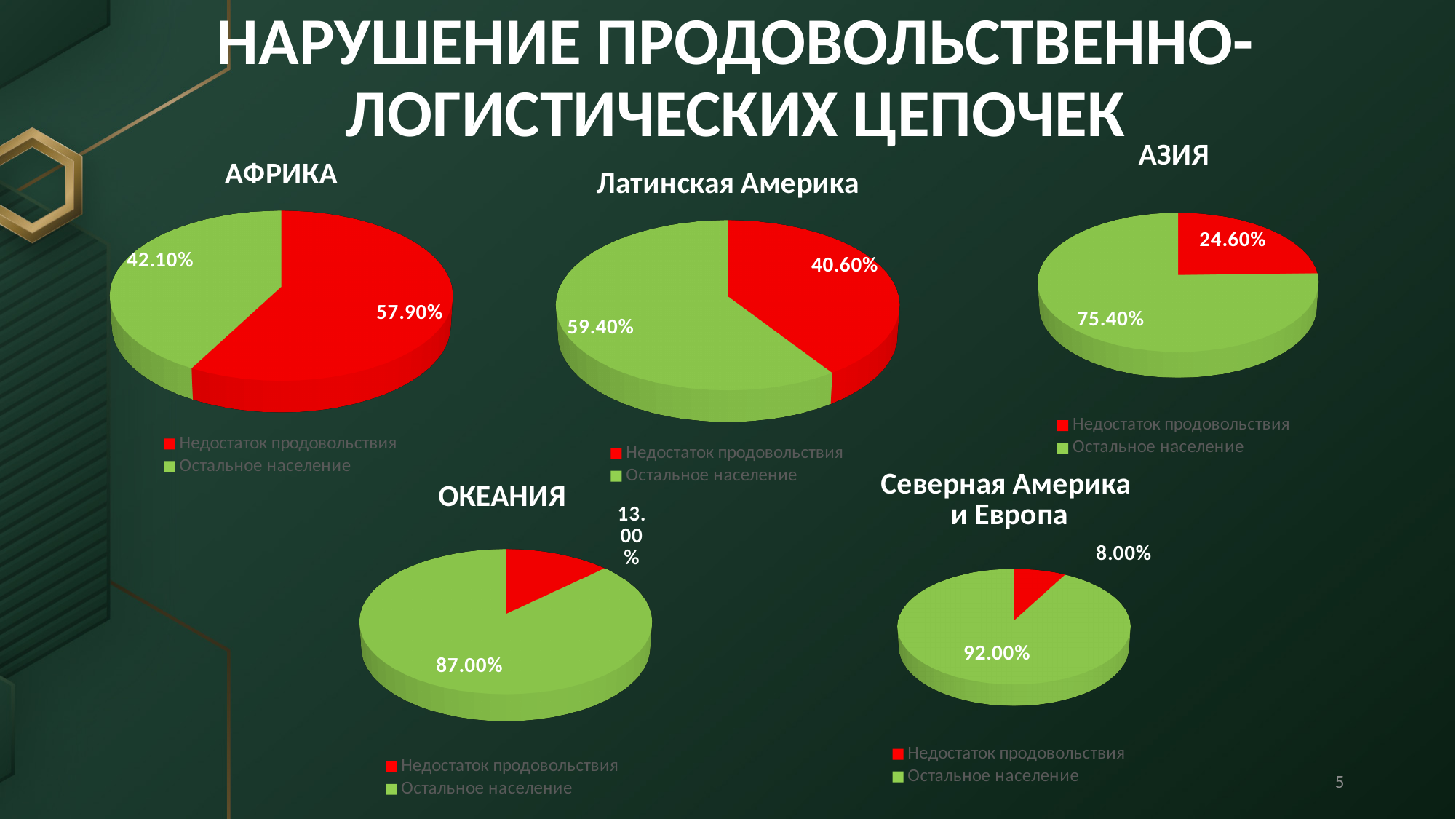
How many pie charts are shown on the slide? 5 In the Северная Америка и Европа chart, what share is labelled for Недостаток продовольствия? 8.00% In the ОКЕАНИЯ chart, what share is labelled for Остальное население? 87.00% In the Латинская Америка chart, what is the difference between the Остальное население slice and the Недостаток продовольствия slice? 18.80% In the АЗИЯ chart, which colour represents Остальное население? Green In the АФРИКА chart, what share is labelled for Недостаток продовольствия? 57.90% How many series does the legend of the Северная Америка и Европа chart list? 2 In the АЗИЯ chart, what is the difference between the Остальное население slice and the Недостаток продовольствия slice? 50.80% In the АЗИЯ chart, what share is labelled for Недостаток продовольствия? 24.60% What kind of chart is the ОКЕАНИЯ chart? Pie chart In the АФРИКА chart, which slice is larger: Недостаток продовольствия or Остальное население? Недостаток продовольствия In the Латинская Америка chart, what share is labelled for Остальное население? 59.40%